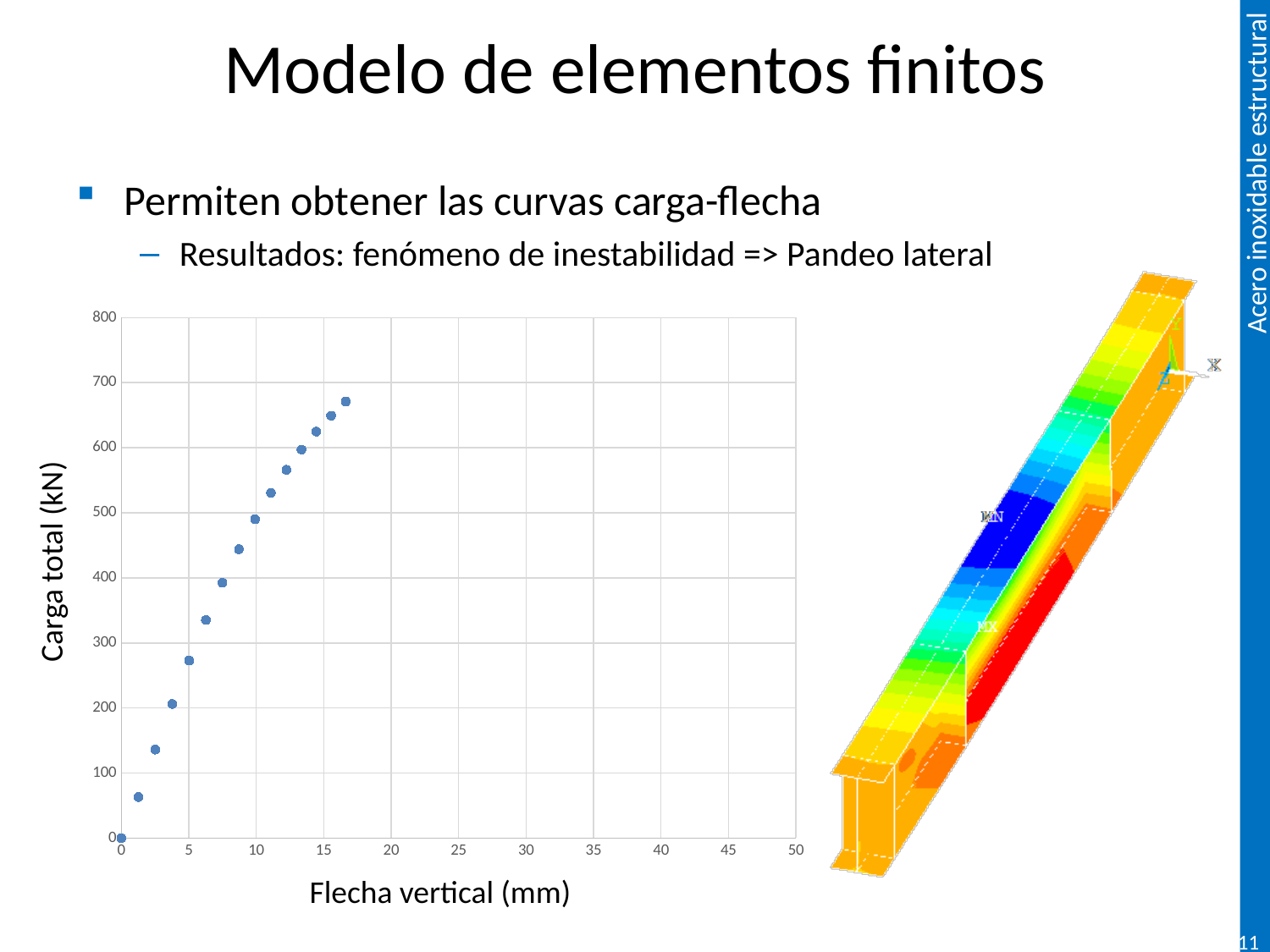
Is the load at a vertical deflection of about 10 mm greater or less than 400 kN? greater What is the title of the horizontal axis of the chart? Flecha vertical (mm) Does the load (Carga total) rise or fall as the vertical deflection (Flecha vertical) increases along the x axis? rises What is the maximum value shown on the horizontal axis of the chart? 50 Is the largest vertical deflection plotted greater or less than 20 mm? less Is the highest plotted load value greater or less than 700 kN? less What is the title of the vertical axis of the chart? Carga total (kN) How many data points are plotted on the chart? 15 What kind of chart is shown on the slide? scatter chart